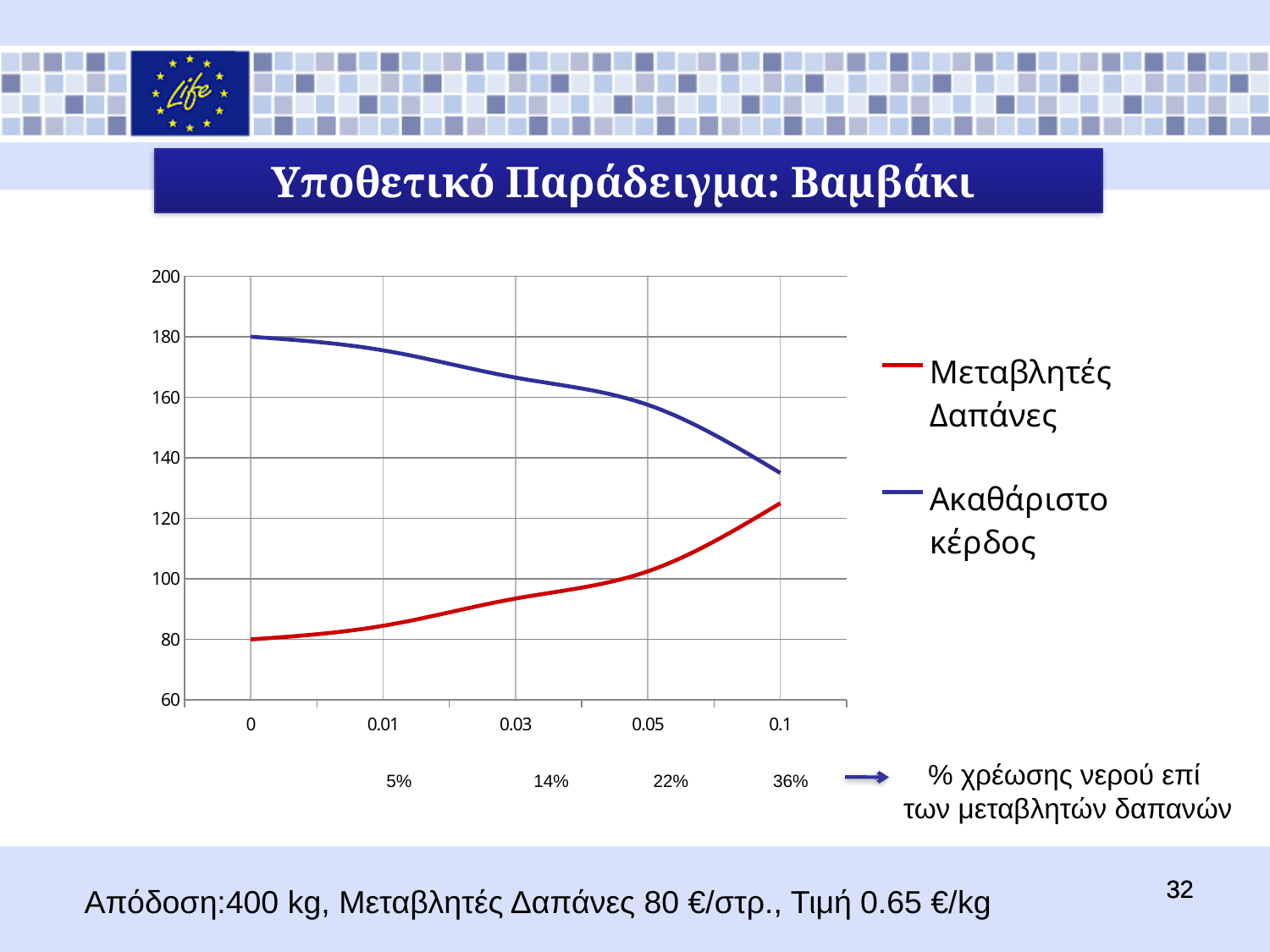
Which colour is used for the Μεταβλητές Δαπάνες line? red What is the value of Μεταβλητές Δαπάνες at x = 0? 80 Is the value of Μεταβλητές Δαπάνες at x = 0.1 greater or less than 120? greater Does the Μεταβλητές Δαπάνες line rise or fall as x increases from 0 to 0.1? rise How many series does the legend list? 2 What is the value of Ακαθάριστο κέρδος at x = 0? 180 What is the difference between Ακαθάριστο κέρδος and Μεταβλητές Δαπάνες at x = 0? 100 Does the Ακαθάριστο κέρδος line rise or fall as x increases from 0 to 0.1? fall Is the value of Ακαθάριστο κέρδος at x = 0.1 greater or less than 140? less How many x-axis categories are plotted on the chart? 5 At x = 0.1, which series has the larger value, Ακαθάριστο κέρδος or Μεταβλητές Δαπάνες? Ακαθάριστο κέρδος What kind of chart is shown on the slide? line chart